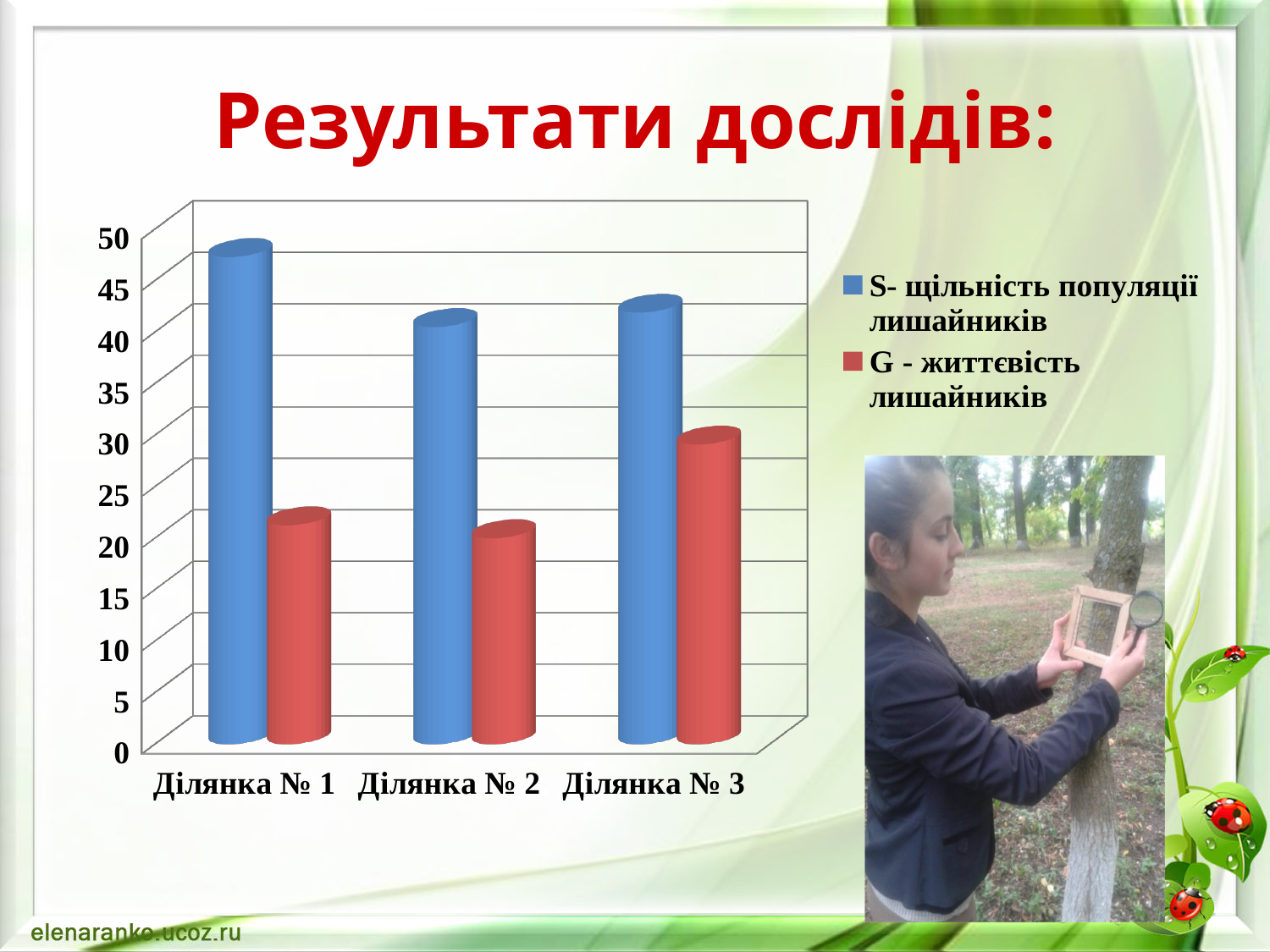
What is the title of the slide containing the chart? Результати дослідів: Which category has the highest value for the series 'S- щільність популяції лишайників'? Ділянка № 1 Which colour represents the series 'G - життєвість лишайників' in the chart? red Which category has the highest value for the series 'G - життєвість лишайників'? Ділянка № 3 Is the value of 'S- щільність популяції лишайників' for Ділянка № 1 greater or less than 40? greater Is the value of 'G - життєвість лишайників' for Ділянка № 1 greater or less than 25? less How many series does the chart legend list? 2 For Ділянка № 3, which series has the larger value: 'S- щільність популяції лишайників' or 'G - життєвість лишайників'? S- щільність популяції лишайників How many categories (ділянки) are shown on the x axis of the chart? 3 What kind of chart is shown on the slide? bar chart Is the value of 'G - життєвість лишайників' for Ділянка № 3 greater or less than 25? greater For Ділянка № 1, which series has the larger value: 'S- щільність популяції лишайників' or 'G - життєвість лишайників'? S- щільність популяції лишайників